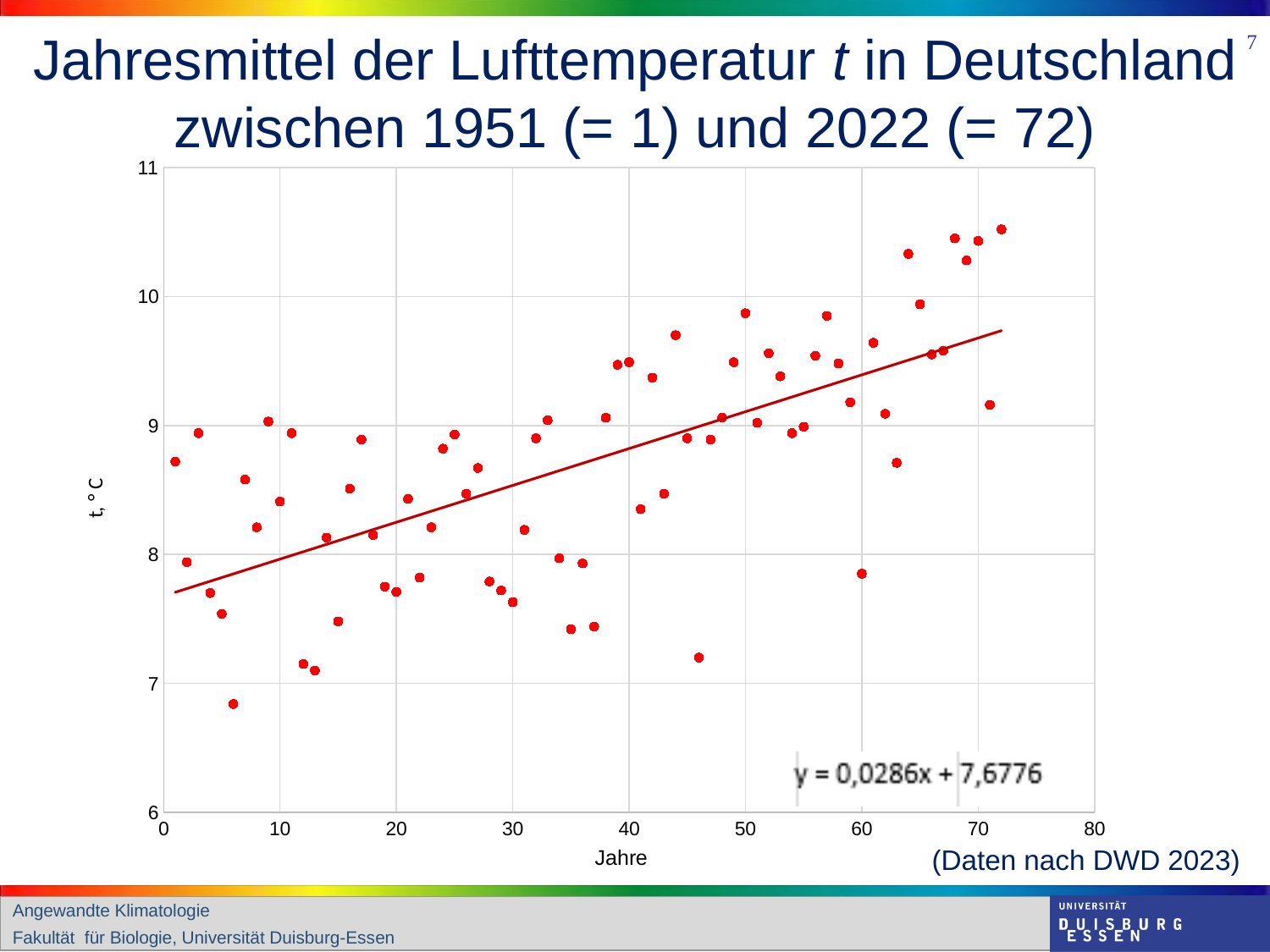
Is the value for year 60 greater or less than 9 °C? less What kind of chart is shown on the slide? Scatter chart Is the value for year 1 greater or less than 9 °C? less Is the value for year 64 greater or less than 10 °C? greater How many years (data points) does the chart cover according to the title? 72 What is the equation of the trend line shown on the chart? y = 0,0286x + 7,6776 Do the annual mean temperatures generally rise or fall as the year index increases along the x axis? Rise What is the label of the x axis? Jahre